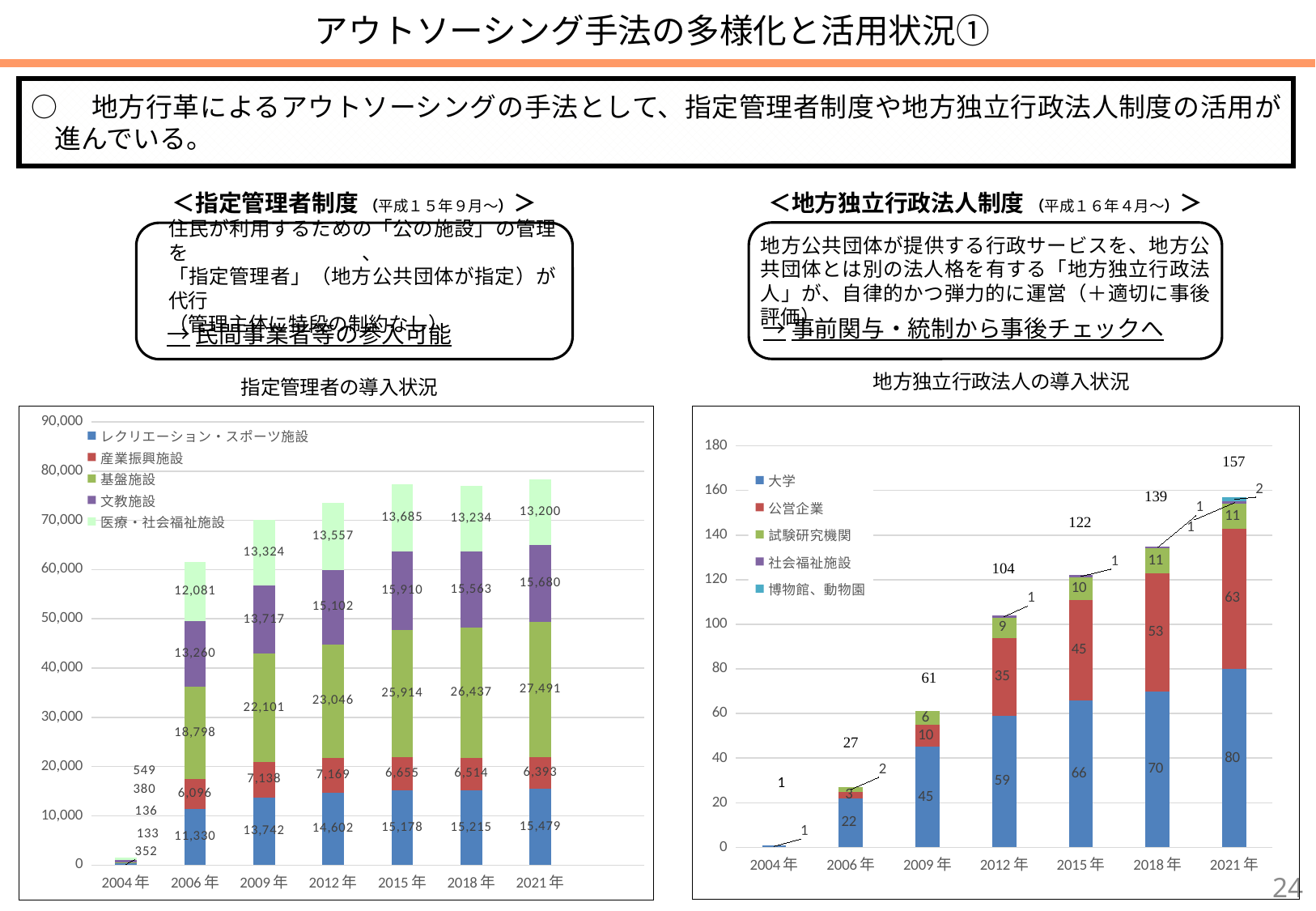
How many series does the legend of the left chart (指定管理者の導入状況) list? 5 In the right chart (地方独立行政法人の導入状況), what is the value for 大学 in 2021年? 80 In the left chart (指定管理者の導入状況), which is larger in 2015年: 基盤施設 or 文教施設? 基盤施設 What kind of chart is the right chart (地方独立行政法人の導入状況)? Stacked bar chart In the right chart (地方独立行政法人の導入状況), what is the total shown above the bar for 2018年? 139 How many years are shown on the x axis of the left chart (指定管理者の導入状況)? 7 In the left chart (指定管理者の導入状況), what is the value for 基盤施設 in 2021年? 27,491 In the right chart (地方独立行政法人の導入状況), do the 大学 values rise or fall from 2006年 to 2021年? Rise In the right chart (地方独立行政法人の導入状況), what is the difference between the 大学 values for 2021年 and 2018年? 10 In the right chart (地方独立行政法人の導入状況), which year has the highest total? 2021年 In the left chart (指定管理者の導入状況), what is the value for レクリエーション・スポーツ施設 in 2006年? 11,330 In the right chart (地方独立行政法人の導入状況), what is the value for 公営企業 in 2012年? 35